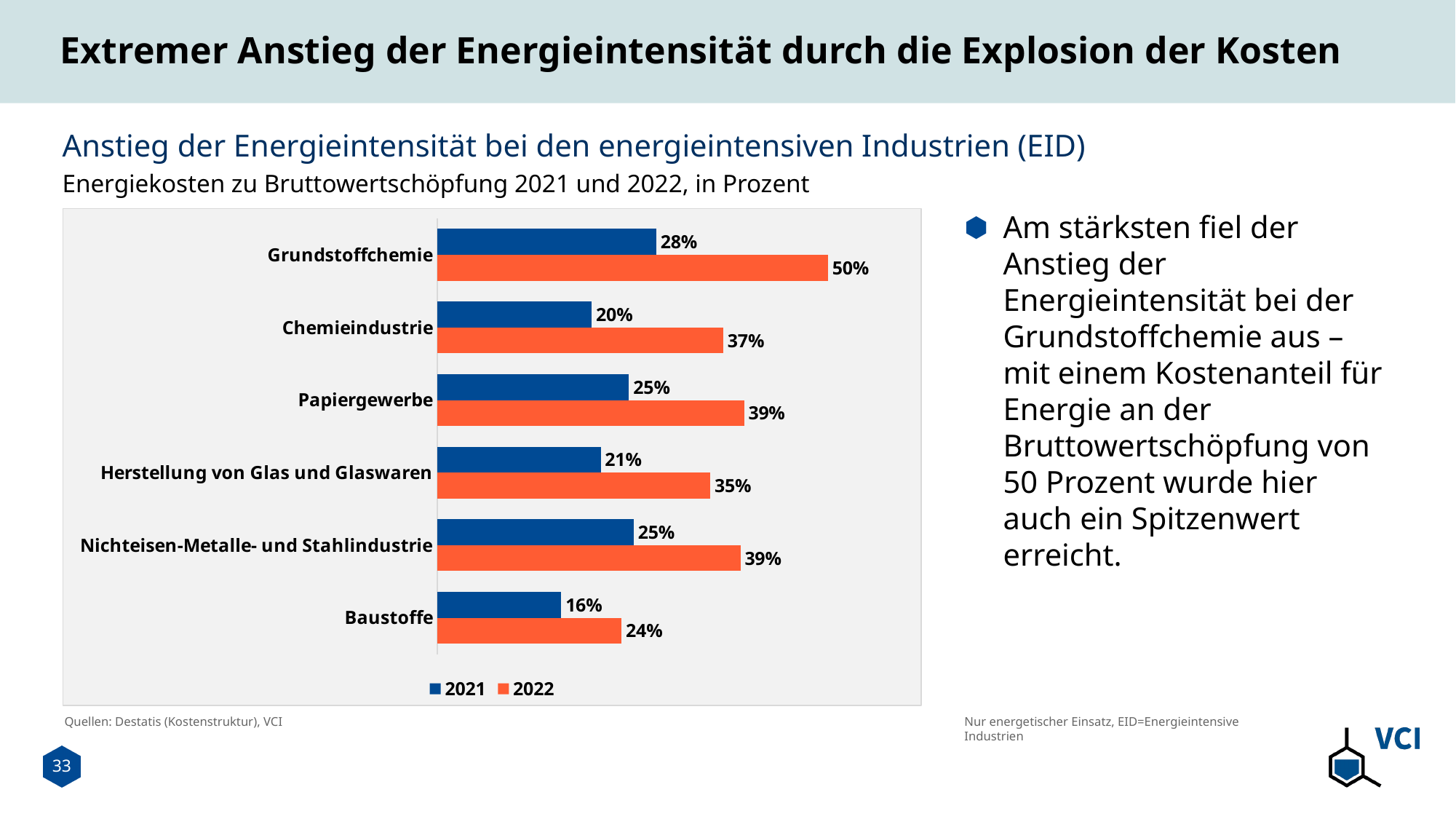
Which series is shown in orange according to the legend? 2022 What is the difference between the 2022 and 2021 values for Chemieindustrie? 17 percentage points What is the 2021 value for Baustoffe? 16% How many categories are shown in the chart? 6 Which category has the lowest 2021 value? Baustoffe What is the difference between the 2022 and 2021 values for Grundstoffchemie? 22 percentage points What is the 2022 value for Herstellung von Glas und Glaswaren? 35% Which is larger, the 2022 value for Papiergewerbe or the 2022 value for Chemieindustrie? Papiergewerbe What is the 2022 value for Grundstoffchemie? 50% How many series does the legend list? 2 What kind of chart is shown on the slide? Bar chart Which category has the highest 2022 value? Grundstoffchemie